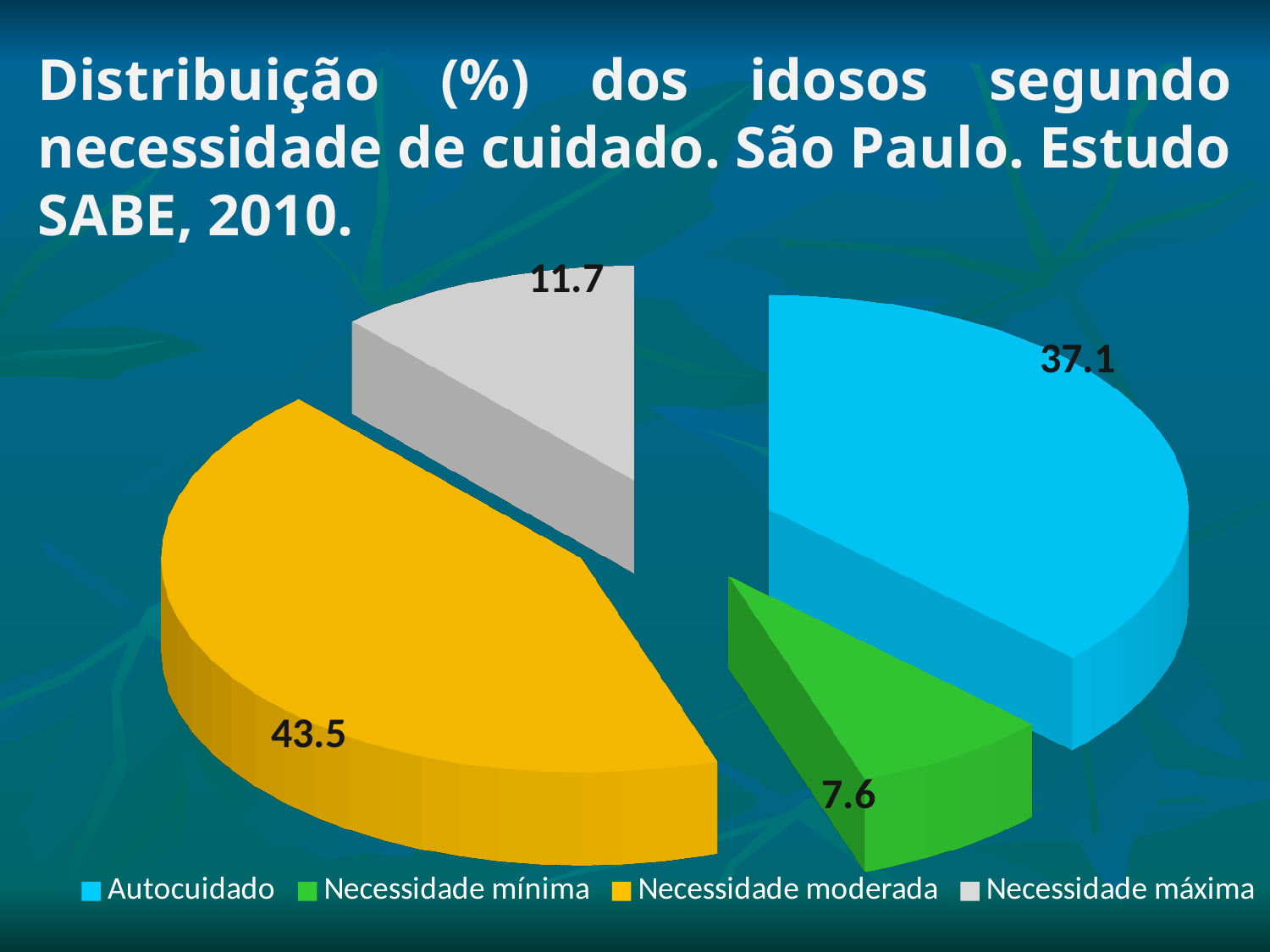
What is the value for Necessidade mínima? 7.6 Which is larger, the value for Autocuidado or the value for Necessidade máxima? Autocuidado What kind of chart is shown on the slide? pie chart What is the value for Autocuidado? 37.1 How many slices does the pie chart have? 4 What is the value for Necessidade máxima? 11.7 Which colour represents Necessidade mínima in the legend? green What is the difference between the values for Necessidade moderada and Autocuidado? 6.4 What is the value for Necessidade moderada? 43.5 What is the difference between the values for Necessidade máxima and Necessidade mínima? 4.1 Which category has the smallest slice? Necessidade mínima Which category has the largest slice? Necessidade moderada